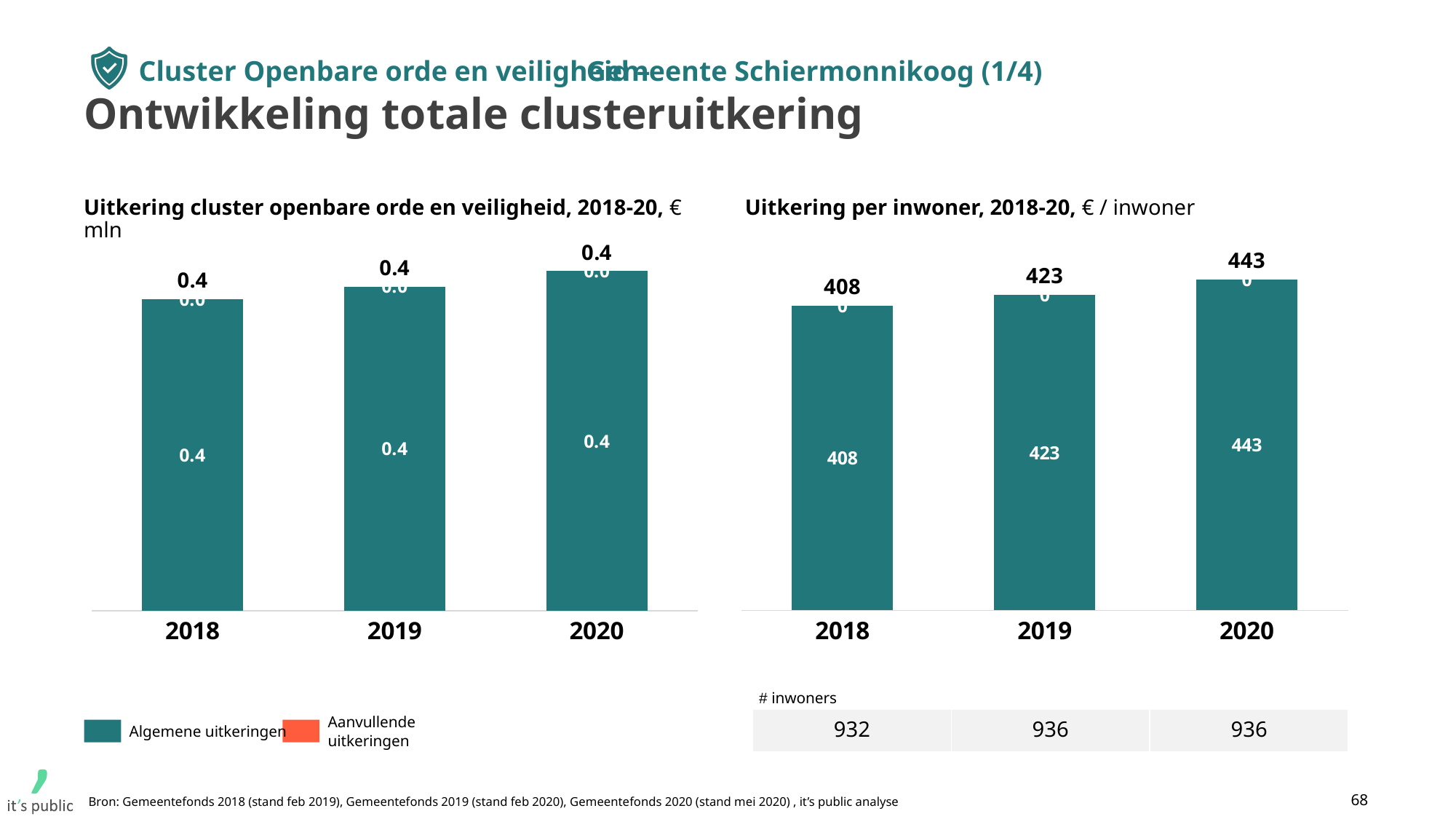
In the chart 'Uitkering per inwoner, 2018-20', what is the value for 2018? 408 In the chart 'Uitkering per inwoner, 2018-20', which year has the lowest value? 2018 How many years are shown on the x axis of the chart 'Uitkering cluster openbare orde en veiligheid, 2018-20'? 3 In the chart 'Uitkering per inwoner, 2018-20', is the value for 2019 larger than the value for 2018? Yes In the chart 'Uitkering per inwoner, 2018-20', which year has the highest value? 2020 What kind of chart is 'Uitkering per inwoner, 2018-20'? Bar chart In the chart 'Uitkering per inwoner, 2018-20', do the values rise or fall from 2018 to 2020? Rise How many series does the legend of the left chart list? 2 In the chart 'Uitkering per inwoner, 2018-20', what is the difference between the 2019 and 2018 values? 15 In the chart 'Uitkering per inwoner, 2018-20', what is the difference between the 2020 and 2018 values? 35 In the chart 'Uitkering per inwoner, 2018-20', what is the value for 2020? 443 In the chart 'Uitkering cluster openbare orde en veiligheid, 2018-20', what is the total value shown for 2019? 0.4